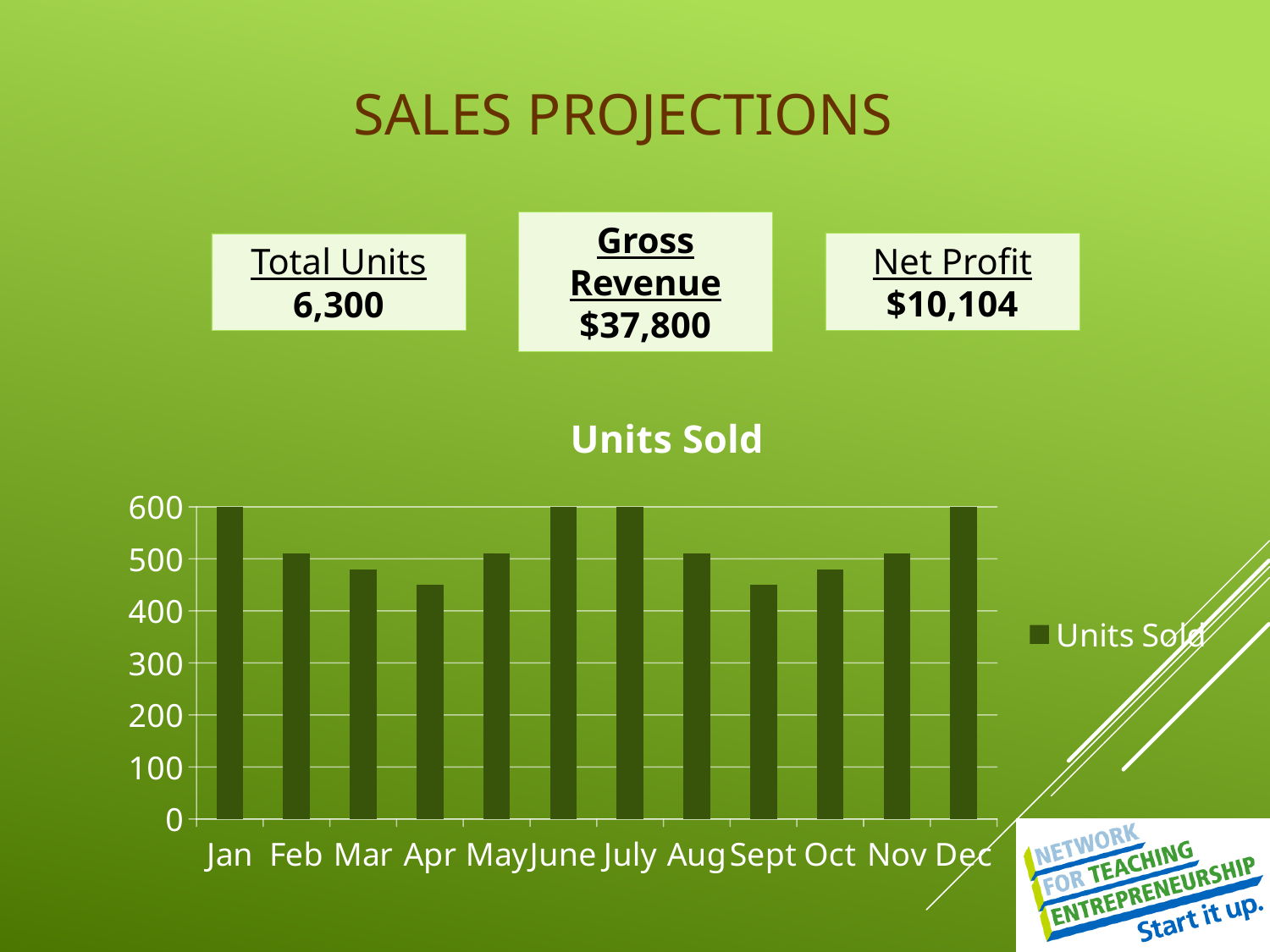
Is the value for Sept greater or less than 400? greater How many series does the legend of the Units Sold chart list? 1 What is the value for June in the Units Sold chart? 600 What is the title of the chart? Units Sold Which is larger, the value for Jan or the value for Apr? Jan How many months are shown on the x axis of the Units Sold chart? 12 Is the value for Mar greater or less than 500? less Is the value for Apr greater or less than 500? less What is the value for Jan in the Units Sold chart? 600 Which is larger, the value for Sept or the value for July? July What kind of chart is shown on the slide? bar chart What is the value for Dec in the Units Sold chart? 600